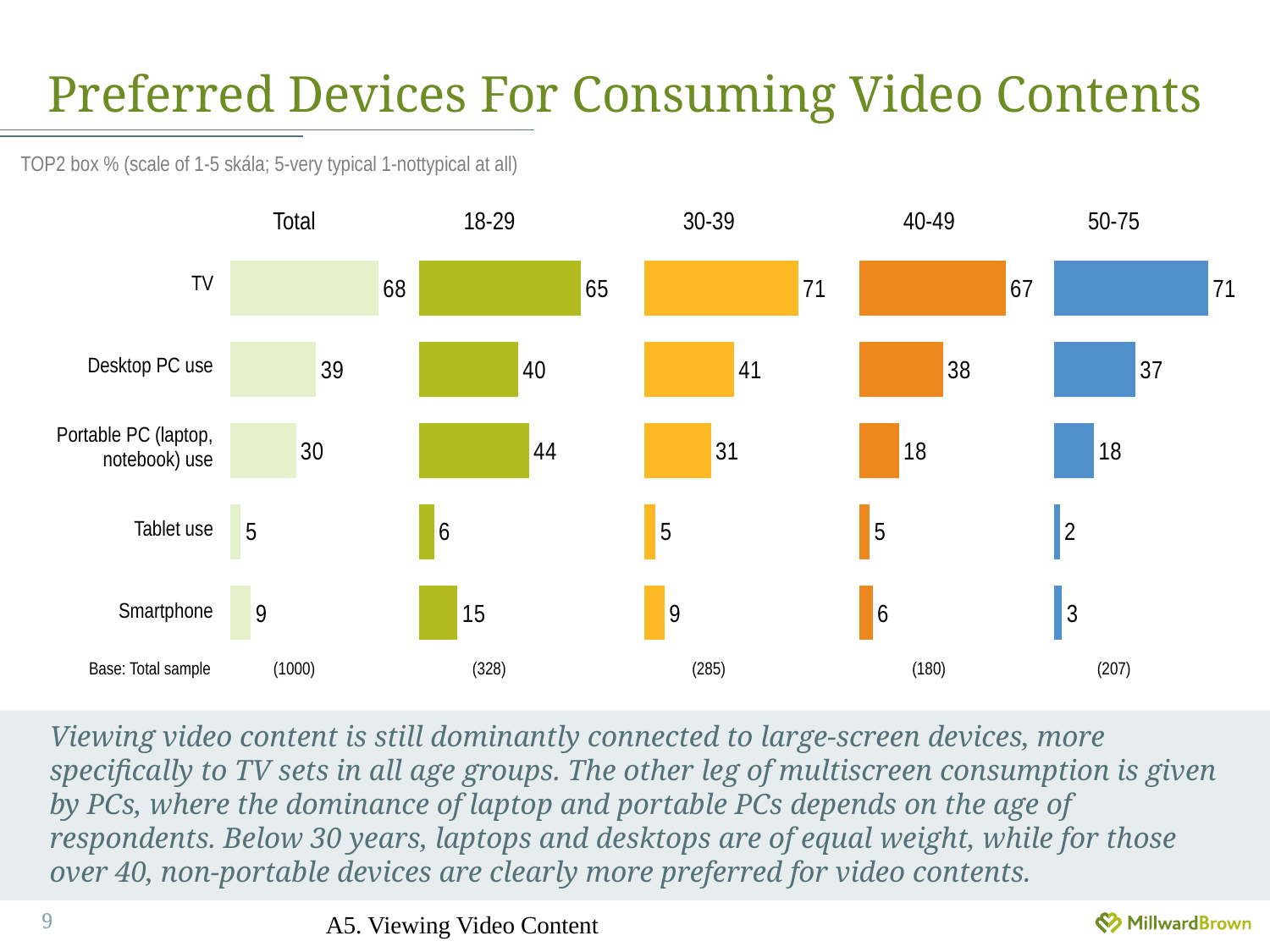
How many age-group charts are shown on the slide, including Total? 5 In the 40-49 chart, what is the difference between the values for TV and Desktop PC use? 29 How many device categories are shown in the Total chart? 5 What kind of chart is used for the Total age group? Bar chart In the 18-29 chart, what is the value for Portable PC (laptop, notebook) use? 44 In the Total chart, what is the value for Desktop PC use? 39 In the 30-39 chart, what is the value for Tablet use? 5 In the 50-75 chart, what is the value for Smartphone? 3 In the 18-29 chart, which is larger: Desktop PC use or Portable PC (laptop, notebook) use? Portable PC (laptop, notebook) use In the Total chart, what is the difference between the values for TV and Portable PC (laptop, notebook) use? 38 In the 50-75 chart, which device has the lowest value? Tablet use In the 30-39 chart, which device has the highest value? TV